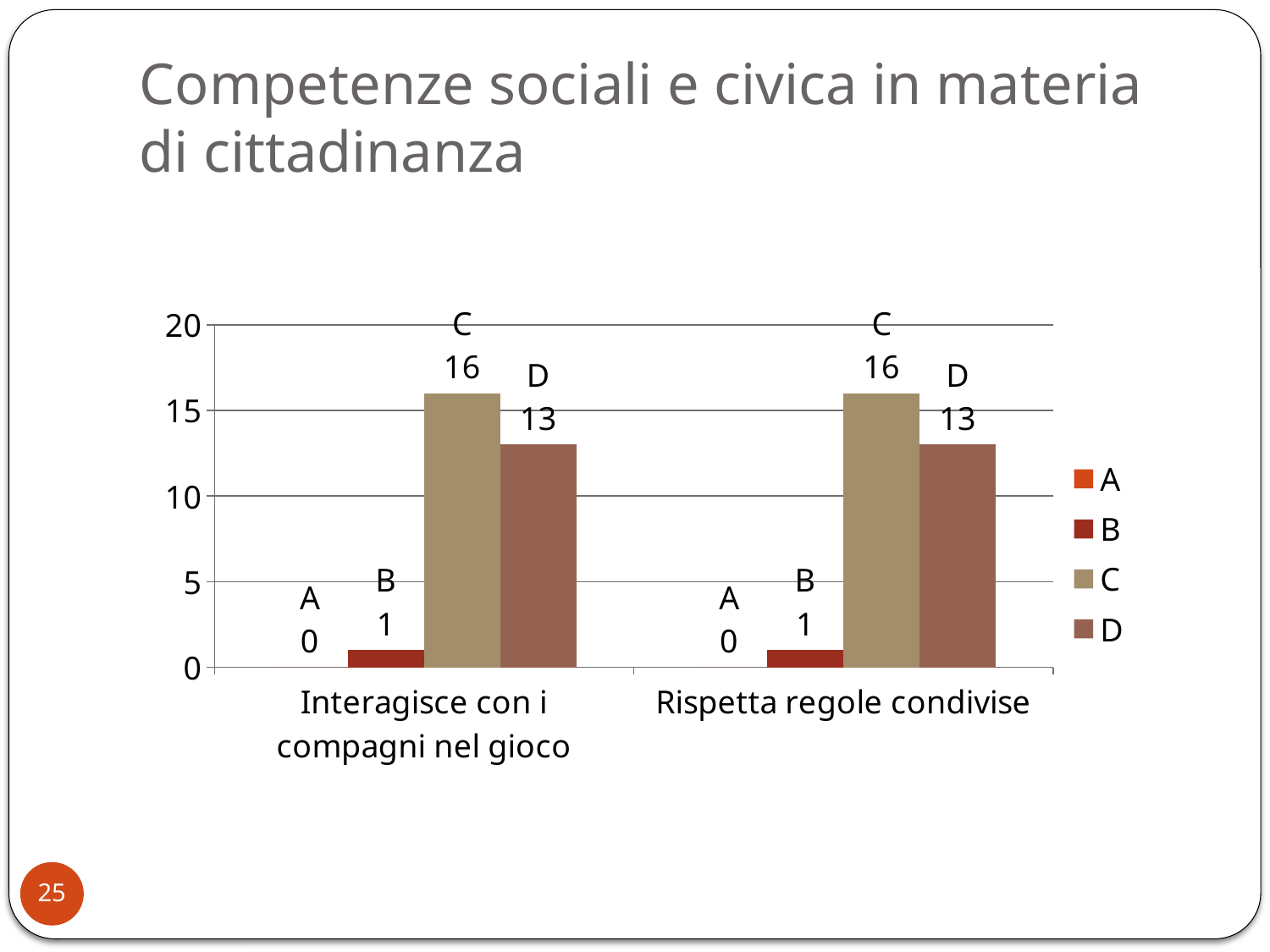
What is the value of series C for "Interagisce con i compagni nel gioco"? 16 How many categories are shown on the x axis? 2 Which series has the lowest value for "Interagisce con i compagni nel gioco"? A What is the value of series D for "Rispetta regole condivise"? 13 What is the difference between series C and series D for "Interagisce con i compagni nel gioco"? 3 Which series has the highest value for "Rispetta regole condivise"? C For "Rispetta regole condivise", which is larger: series B or series D? D How many series does the legend list? 4 What kind of chart is shown on the slide? bar chart Is the value of series C for "Rispetta regole condivise" greater or less than 15? greater What is the value of series A for "Rispetta regole condivise"? 0 What is the value of series B for "Interagisce con i compagni nel gioco"? 1